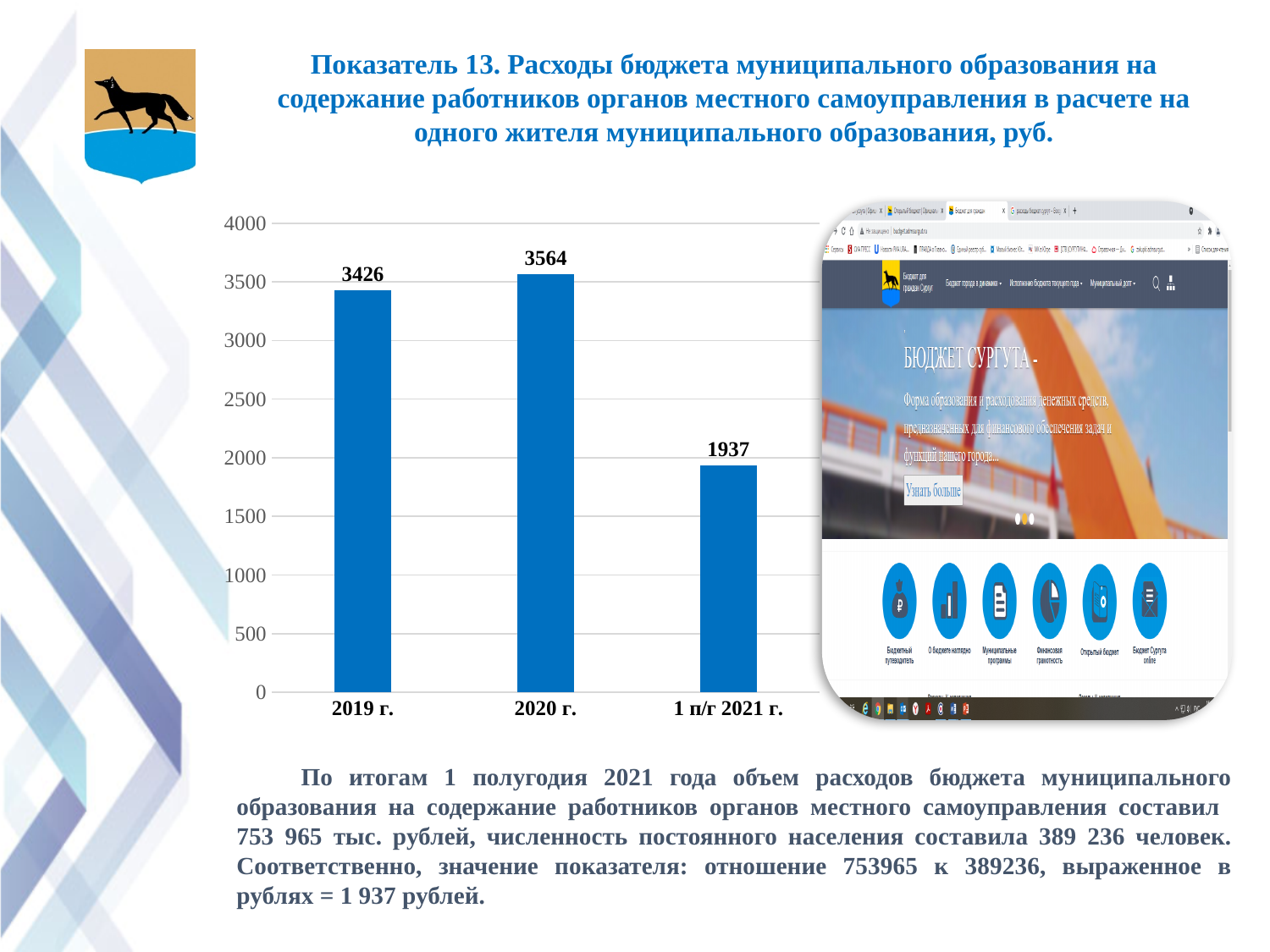
Which is larger, the value for 2019 г. or the value for 1 п/г 2021 г.? 2019 г. What is the value for 1 п/г 2021 г.? 1937 What is the difference between the values for 2020 г. and 2019 г.? 138 What is the value for 2019 г.? 3426 What is the difference between the values for 2020 г. and 1 п/г 2021 г.? 1627 Which category has the highest value? 2020 г. What is the maximum value shown on the vertical axis? 4000 Is the value for 1 п/г 2021 г. greater or less than 2000? less What is the value for 2020 г.? 3564 What kind of chart is shown on the slide? bar chart How many categories are shown on the x axis? 3 Which category has the lowest value? 1 п/г 2021 г.